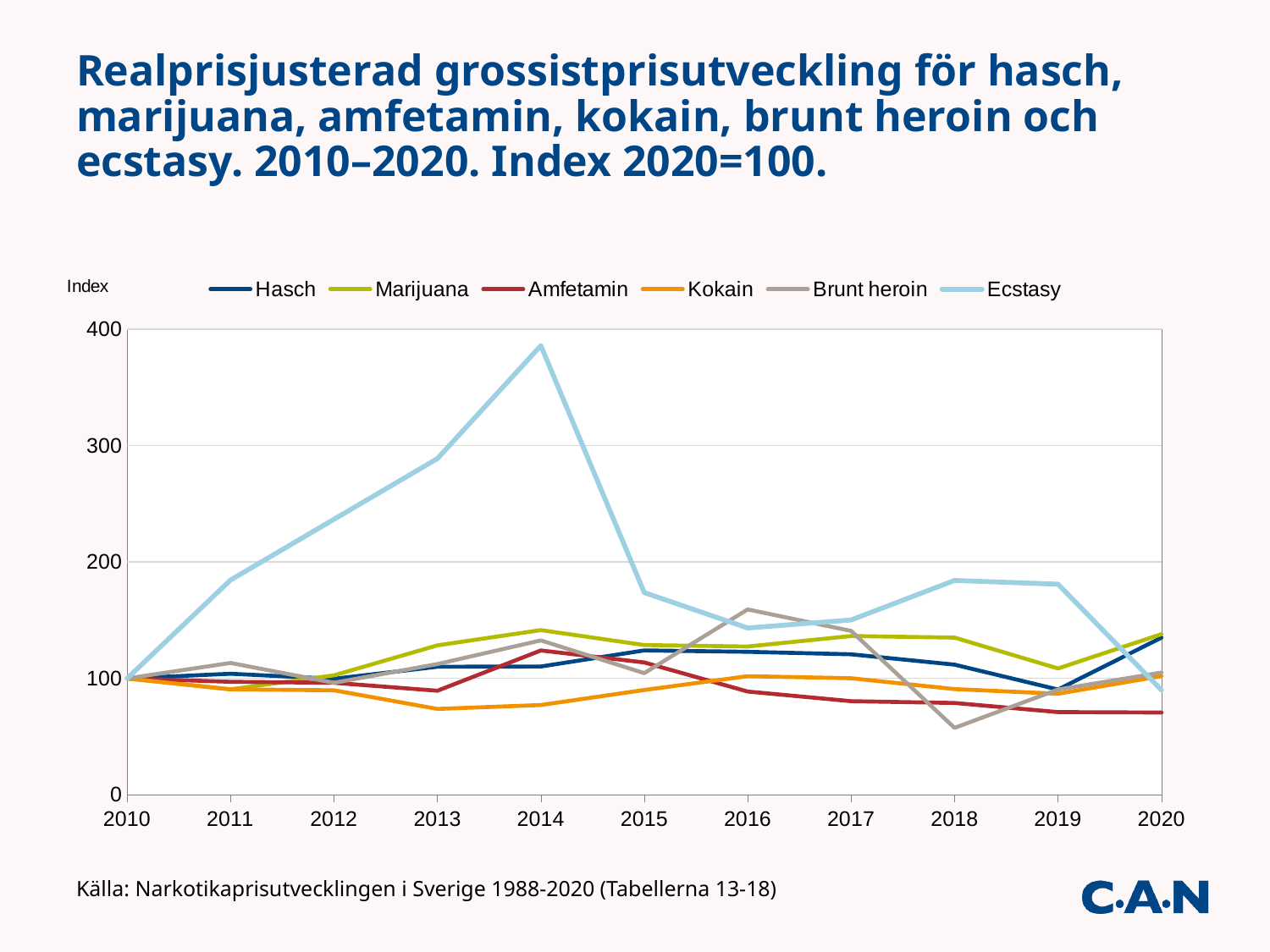
How many years are plotted along the x axis? 11 Does the Ecstasy series rise or fall between 2010 and 2014? rise Is the value for Brunt heroin in 2018 greater or less than 100? less In which year does the Brunt heroin series reach its lowest value? 2018 What is the label on the y axis? Index What kind of chart is shown on the slide? line chart Which series reaches the highest value anywhere on the chart? Ecstasy Is the value for Ecstasy in 2014 greater or less than 300? greater In which year does the Ecstasy series reach its highest value? 2014 Is the value for Amfetamin in 2020 greater or less than 100? less How many series does the legend list? 6 Which is larger in 2014, the value for Ecstasy or the value for Hasch? Ecstasy